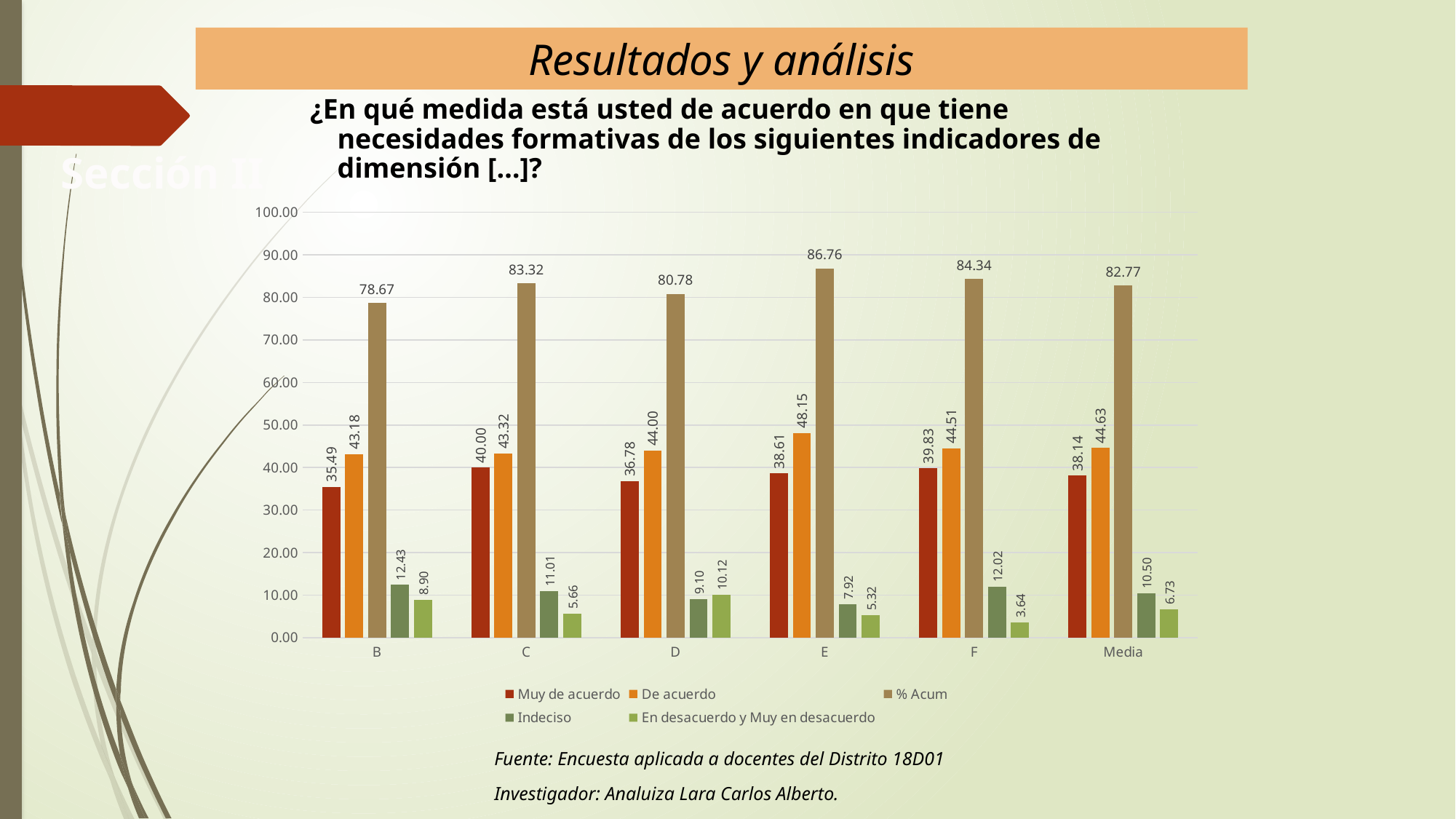
Which is larger, the De acuerdo value for E or the De acuerdo value for C? E What is the En desacuerdo y Muy en desacuerdo value for category F? 3.64 What kind of chart is shown on the slide? bar chart What is the Indeciso value for category B? 12.43 Is the Muy de acuerdo value for C greater or less than 30.00? greater What is the De acuerdo value for category D? 44.00 Which category has the lowest Muy de acuerdo value? B Which category has the highest % Acum value? E How many categories are shown on the x axis? 6 How many series does the legend list? 5 What is the % Acum value for category E? 86.76 What is the difference between the % Acum values for E and B? 8.09